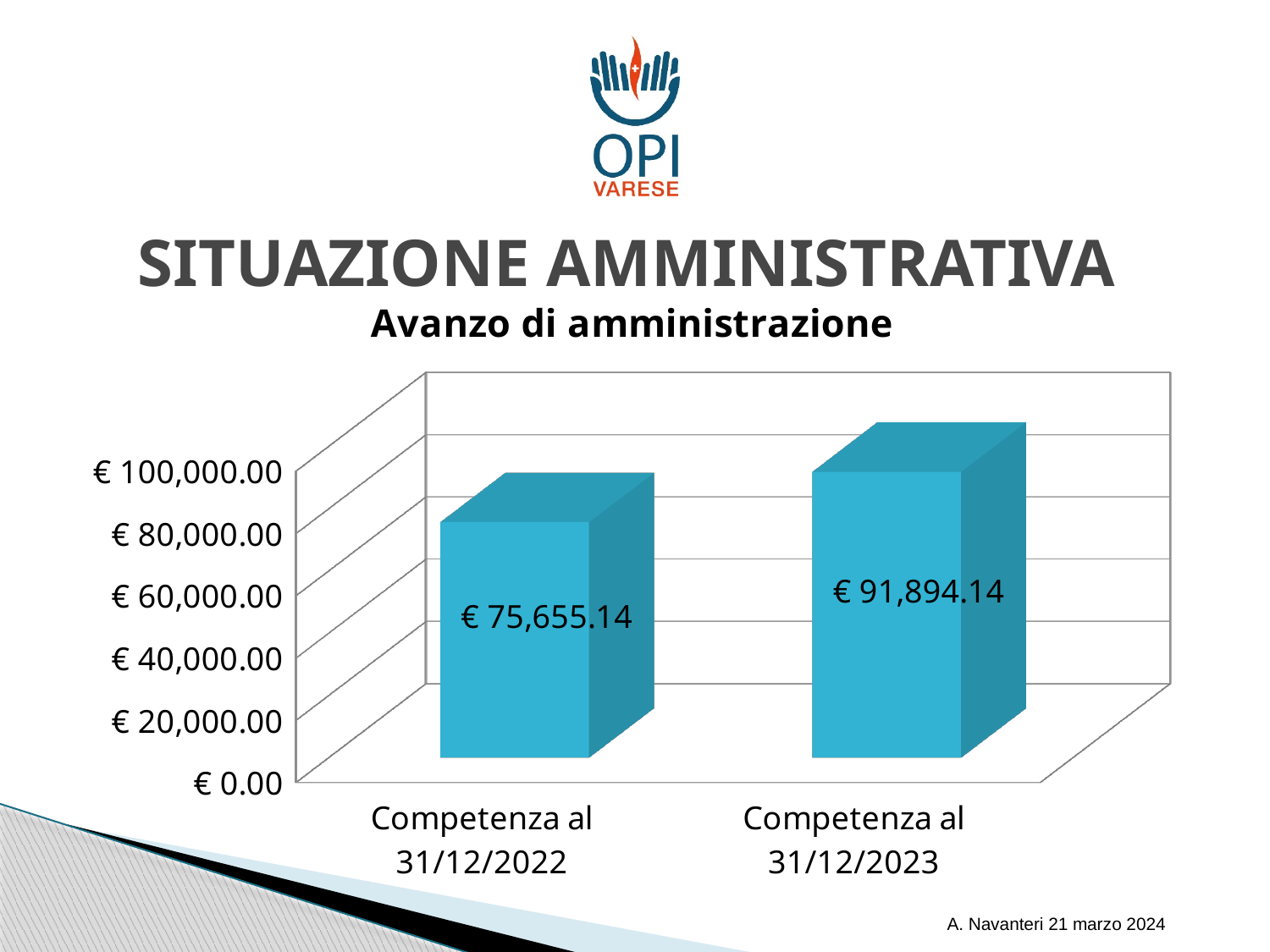
What is the value for Competenza al 31/12/2023? € 91,894.14 Do the values rise or fall from Competenza al 31/12/2022 to Competenza al 31/12/2023? rise What is the difference between the value for Competenza al 31/12/2023 and the value for Competenza al 31/12/2022? € 16,239.00 Which category has the highest value? Competenza al 31/12/2023 Which is larger, the value for Competenza al 31/12/2022 or the value for Competenza al 31/12/2023? Competenza al 31/12/2023 Is the value for Competenza al 31/12/2022 greater or less than € 80,000.00? less Is the value for Competenza al 31/12/2023 greater or less than € 80,000.00? greater How many categories are shown on the chart? 2 What is the value for Competenza al 31/12/2022? € 75,655.14 What is the title of the chart? Avanzo di amministrazione What kind of chart is shown on the slide? bar chart Which category has the lowest value? Competenza al 31/12/2022